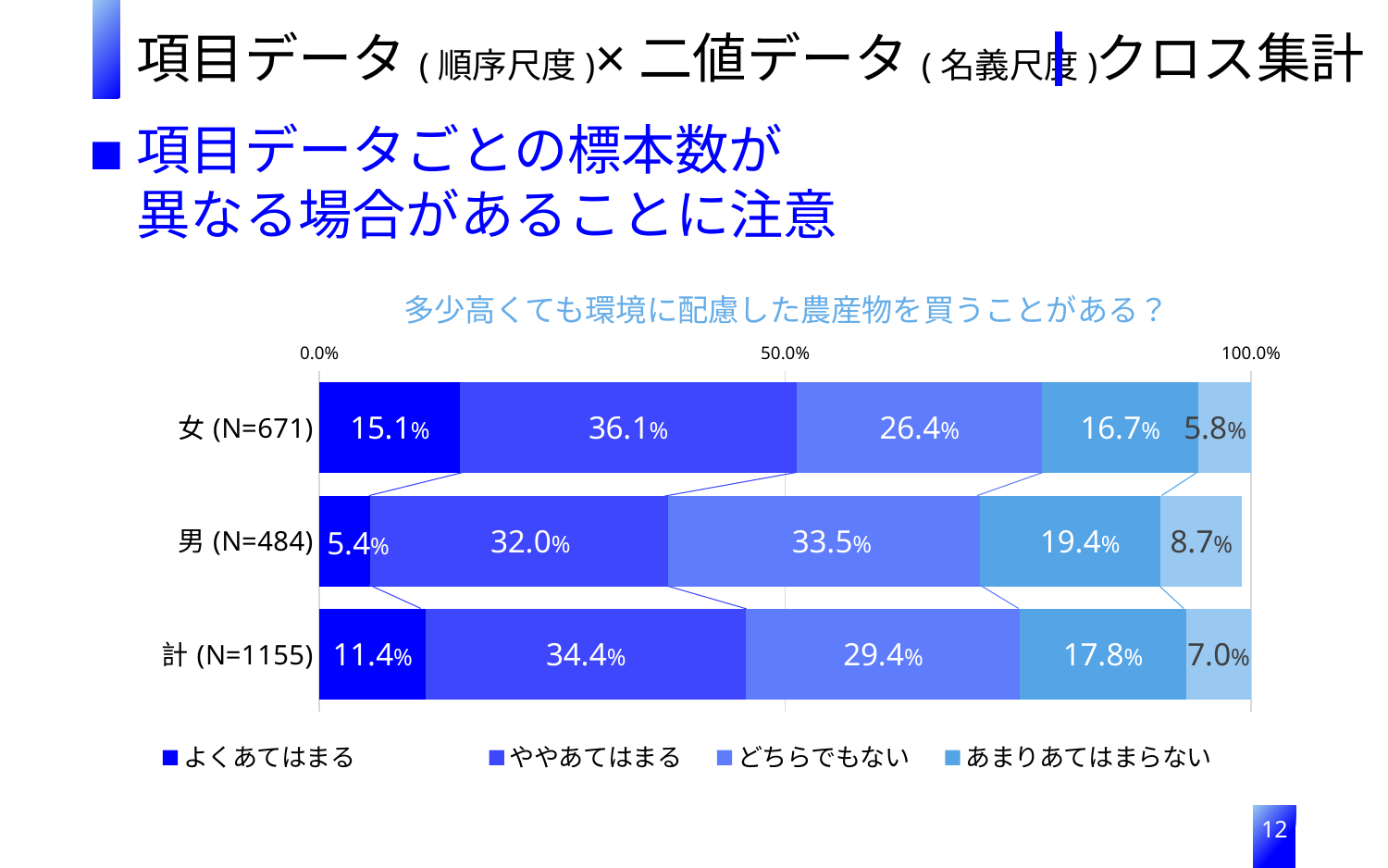
How many series does the legend list? 4 Which is larger: the どちらでもない value for 男 (N=484) or for 女 (N=671)? 男 (N=484) What is the title of the chart? 多少高くても環境に配慮した農産物を買うことがある？ What is the value for あまりあてはまらない in the 計 (N=1155) bar? 17.8% What is the value for よくあてはまる in the 女 (N=671) bar? 15.1% What kind of chart is shown on the slide? Stacked bar chart How many categories (bars) are shown in the chart? 3 What is the difference between the よくあてはまる values for 女 (N=671) and 男 (N=484)? 9.7 percentage points What is the value for どちらでもない in the 男 (N=484) bar? 33.5% What is the value for ややあてはまる in the 計 (N=1155) bar? 34.4% Which category has the highest value for よくあてはまる? 女 (N=671) Which category has the lowest value for あまりあてはまらない? 女 (N=671)